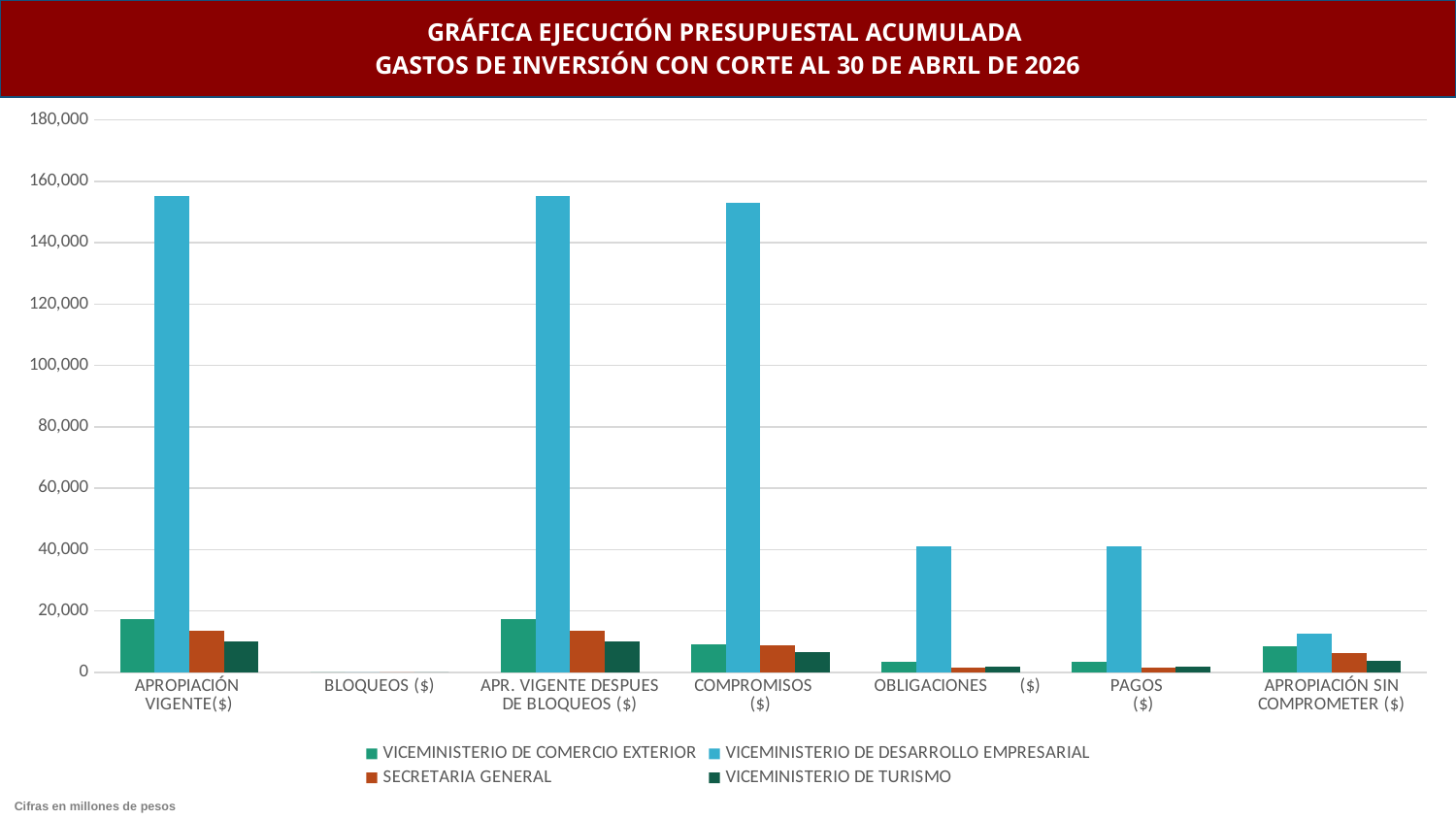
Is the value for VICEMINISTERIO DE DESARROLLO EMPRESARIAL in APROPIACIÓN VIGENTE($) greater or less than 140,000? greater How many categories are shown along the x axis? 7 Which series has the highest value in the APROPIACIÓN VIGENTE($) category? VICEMINISTERIO DE DESARROLLO EMPRESARIAL For VICEMINISTERIO DE COMERCIO EXTERIOR, which is larger: the value in APROPIACIÓN VIGENTE($) or the value in COMPROMISOS ($)? APROPIACIÓN VIGENTE($) Is the value for VICEMINISTERIO DE DESARROLLO EMPRESARIAL in OBLIGACIONES ($) greater or less than 60,000? less Is the value for VICEMINISTERIO DE DESARROLLO EMPRESARIAL in PAGOS ($) greater or less than 20,000? greater How many series does the legend list? 4 Which series has the lowest value in the APROPIACIÓN VIGENTE($) category? VICEMINISTERIO DE TURISMO Which category shows no visible bars for any series? BLOQUEOS ($) What kind of chart is shown on the slide? bar chart What unit are the figures in, according to the note at the bottom of the slide? millones de pesos